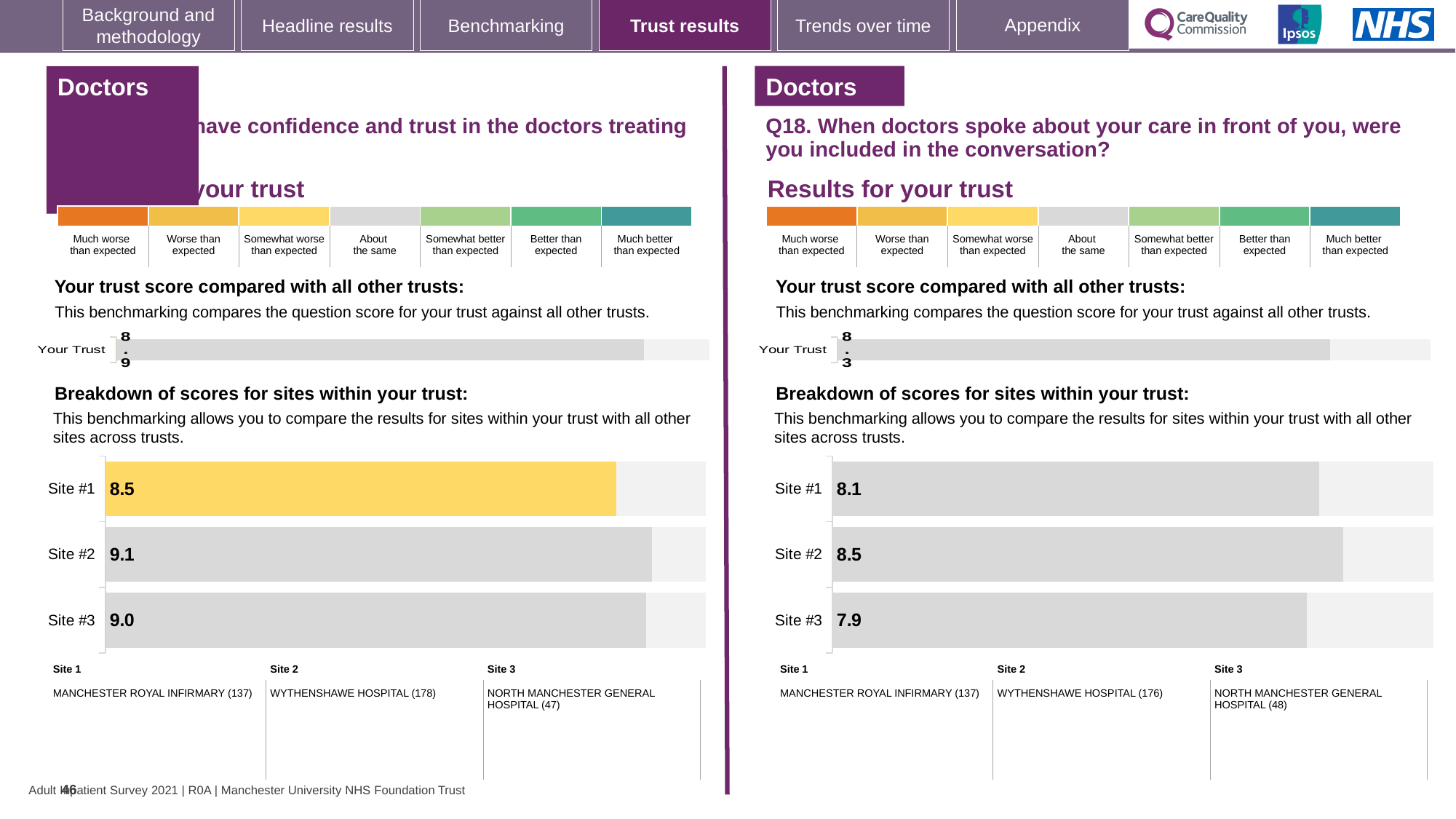
On the Q18 site breakdown chart, which site has the lowest score? Site #3 On the Q18 site breakdown chart, which site has the highest score? Site #2 On the Q18 'Your trust score compared with all other trusts' chart, what is the score for Your Trust? 8.3 Is the score for Site #1 larger on the left-hand site breakdown chart or on the Q18 site breakdown chart? Left-hand chart On the left-hand site breakdown chart, what is the score for Site #1? 8.5 How many sites are shown on the Q18 site breakdown chart? 3 On the left-hand site breakdown chart, what is the difference between the scores for Site #2 and Site #1? 0.6 On the Q18 site breakdown chart, what is the difference between the scores for Site #2 and Site #3? 0.6 On the left-hand site breakdown chart, which site has the highest score? Site #2 On the left-hand 'Your trust score compared with all other trusts' chart, what is the score for Your Trust? 8.9 On the Q18 site breakdown chart, what is the score for Site #3? 7.9 What kind of chart is the Q18 site breakdown chart? Bar chart